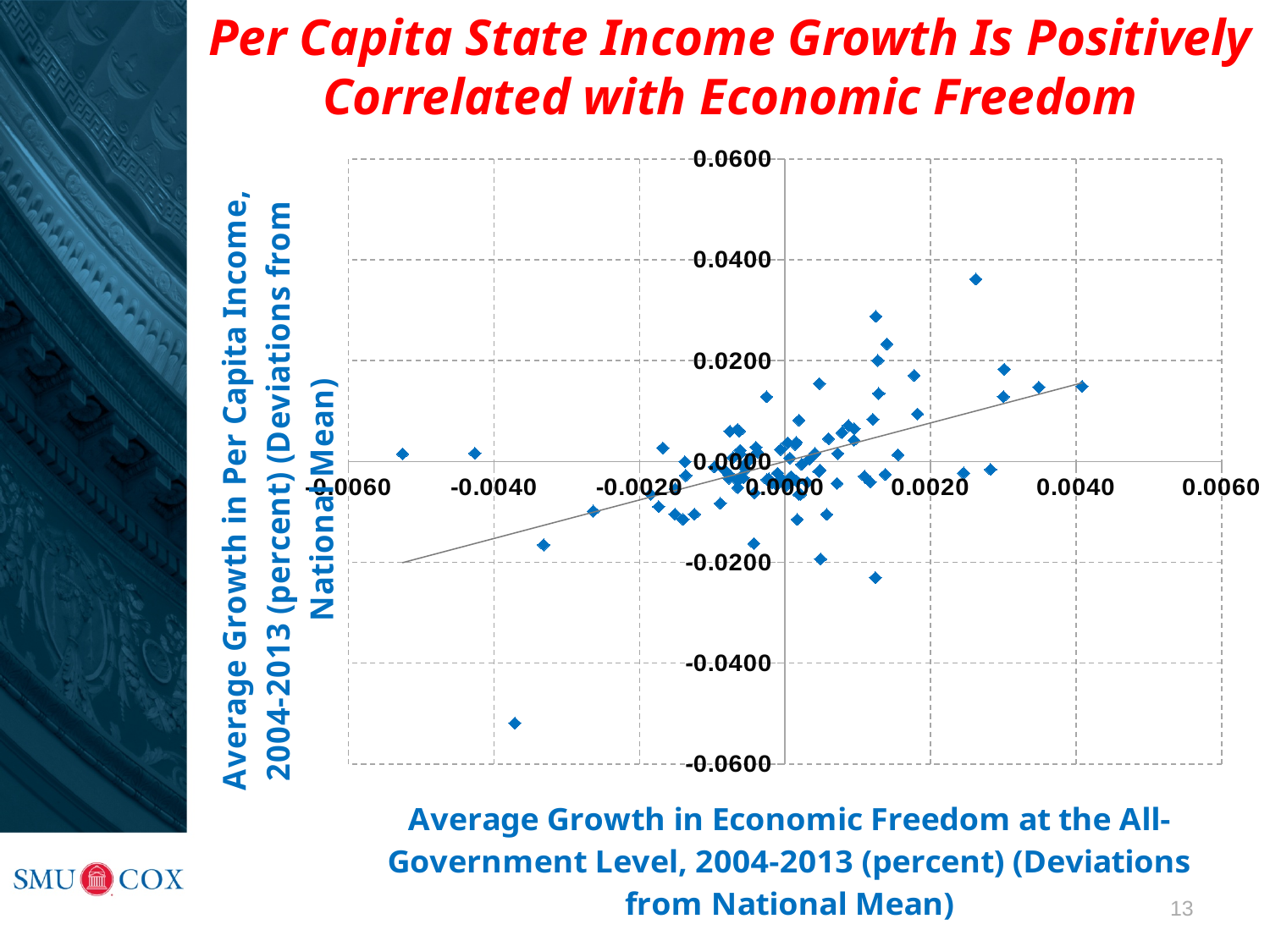
What is the title of the chart on the slide? Per Capita State Income Growth Is Positively Correlated with Economic Freedom Is the y value of the highest plotted point greater or less than 0.0200? greater Is the y value of the highest plotted point greater or less than 0.0400? less Is the x value of the leftmost plotted point greater or less than -0.0040? less What is the label of the x axis of the chart? Average Growth in Economic Freedom at the All-Government Level, 2004-2013 (percent) (Deviations from National Mean) What kind of chart is shown on the slide? Scatter chart According to the chart, is the correlation between per capita state income growth and economic freedom positive or negative? Positive Does the fitted trend line in the chart rise or fall as the x-axis value increases? Rises